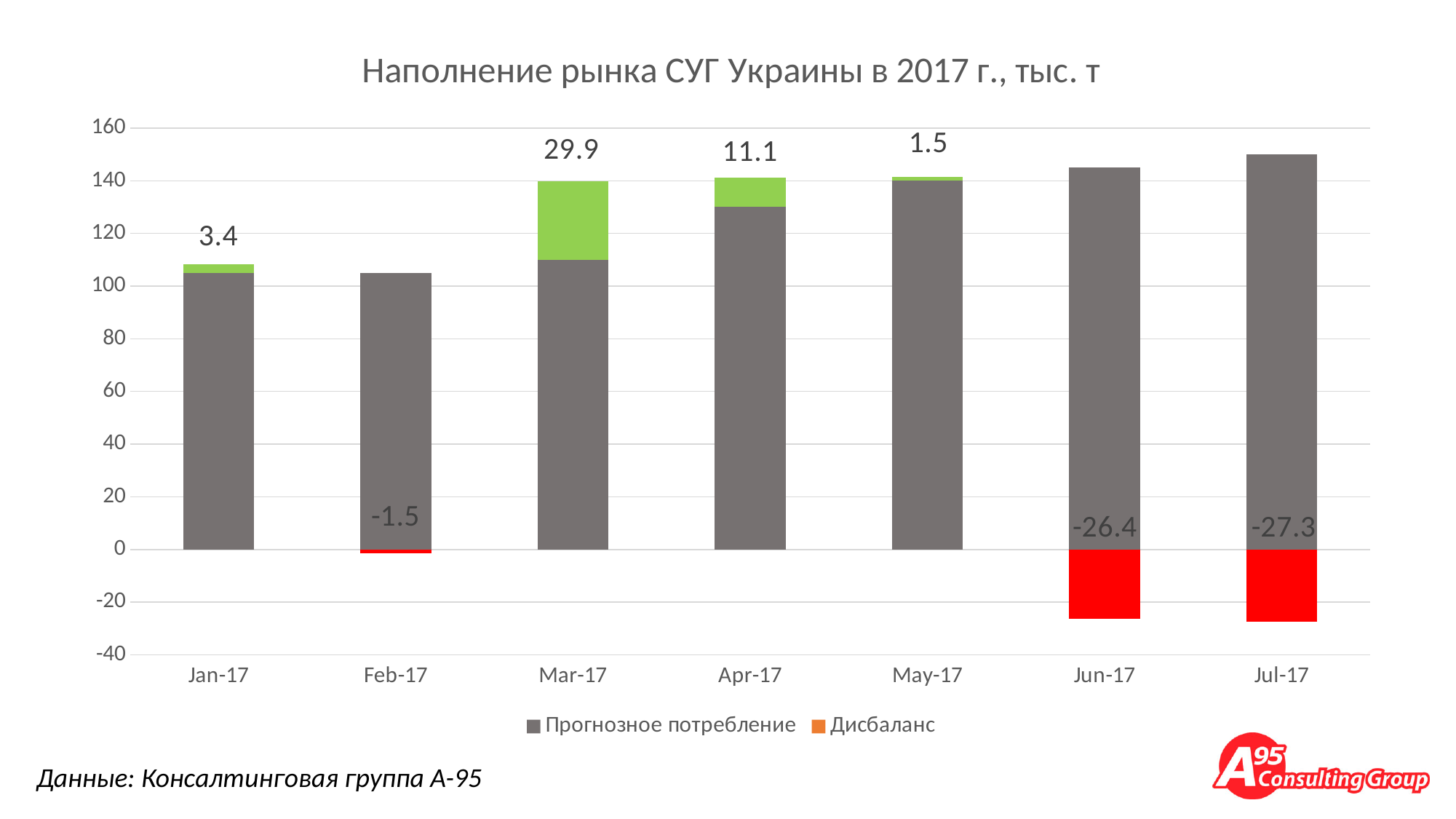
Which month has the lowest Дисбаланс value? Jul-17 Is the Прогнозное потребление value for Jul-17 greater or less than 140? greater Which has the larger Дисбаланс value, Jan-17 or May-17? Jan-17 Which month has the highest Дисбаланс value? Mar-17 How many series does the legend list? 2 Is the Прогнозное потребление value for Jan-17 greater or less than 120? less How many months are shown on the x axis? 7 What is the difference between the Дисбаланс values for Mar-17 and Apr-17? 18.8 What is the value of Дисбаланс for Jul-17? -27.3 What is the value of Дисбаланс for Mar-17? 29.9 What kind of chart is shown on the slide? bar chart Does the Прогнозное потребление series rise or fall from Jan-17 to Jul-17? rises